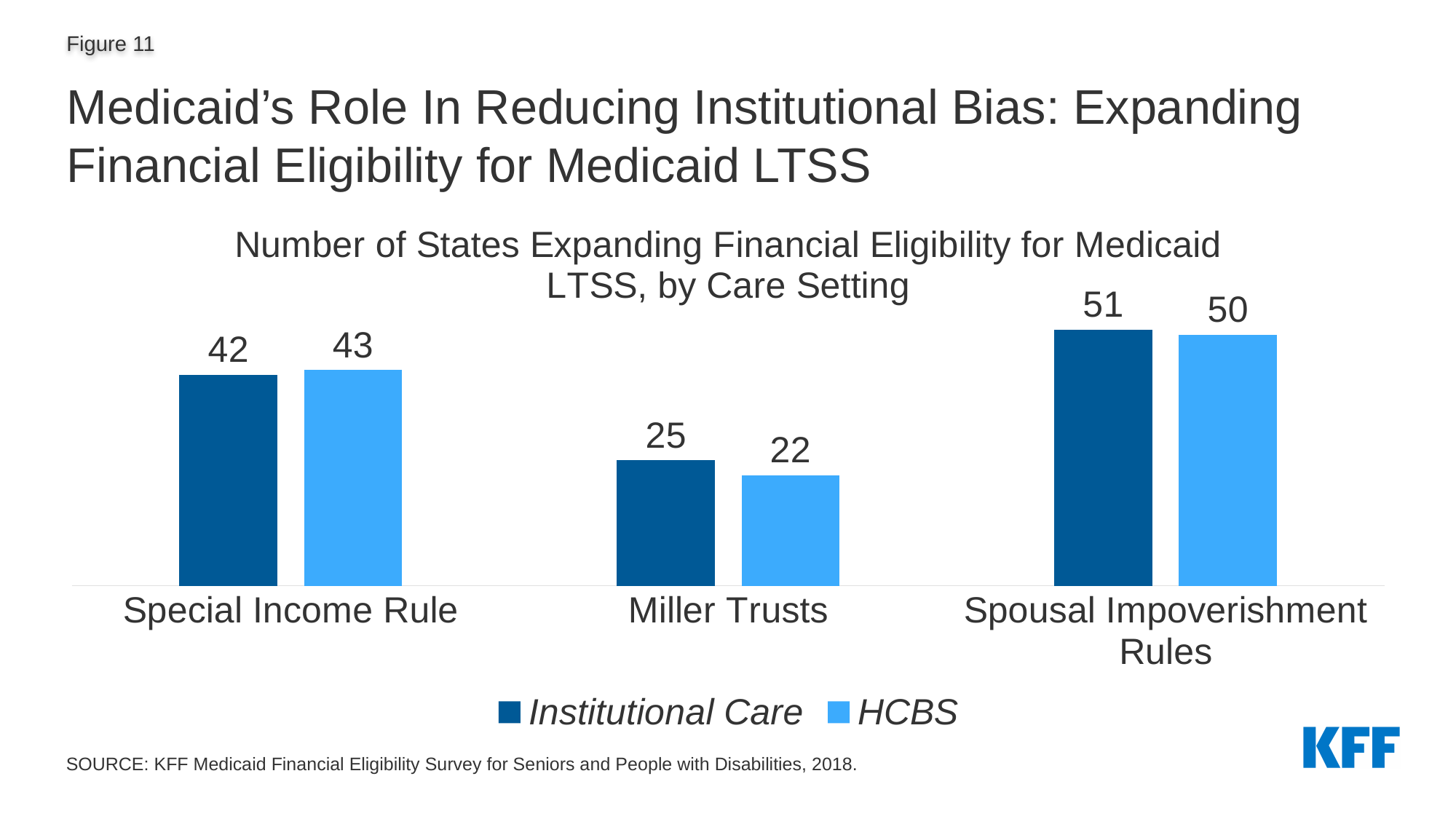
What is the difference between the Institutional Care values for Spousal Impoverishment Rules and Special Income Rule? 9 What is the Institutional Care value for Special Income Rule? 42 What kind of chart is shown on the slide? Bar chart What is the HCBS value for Miller Trusts? 22 Which category has the highest Institutional Care value? Spousal Impoverishment Rules What is the title of the chart? Number of States Expanding Financial Eligibility for Medicaid LTSS, by Care Setting For Miller Trusts, which is larger: Institutional Care or HCBS? Institutional Care What is the HCBS value for Spousal Impoverishment Rules? 50 What is the difference between the Institutional Care and HCBS values for Miller Trusts? 3 How many series does the legend list? 2 How many categories are shown on the x axis? 3 Which category has the lowest HCBS value? Miller Trusts